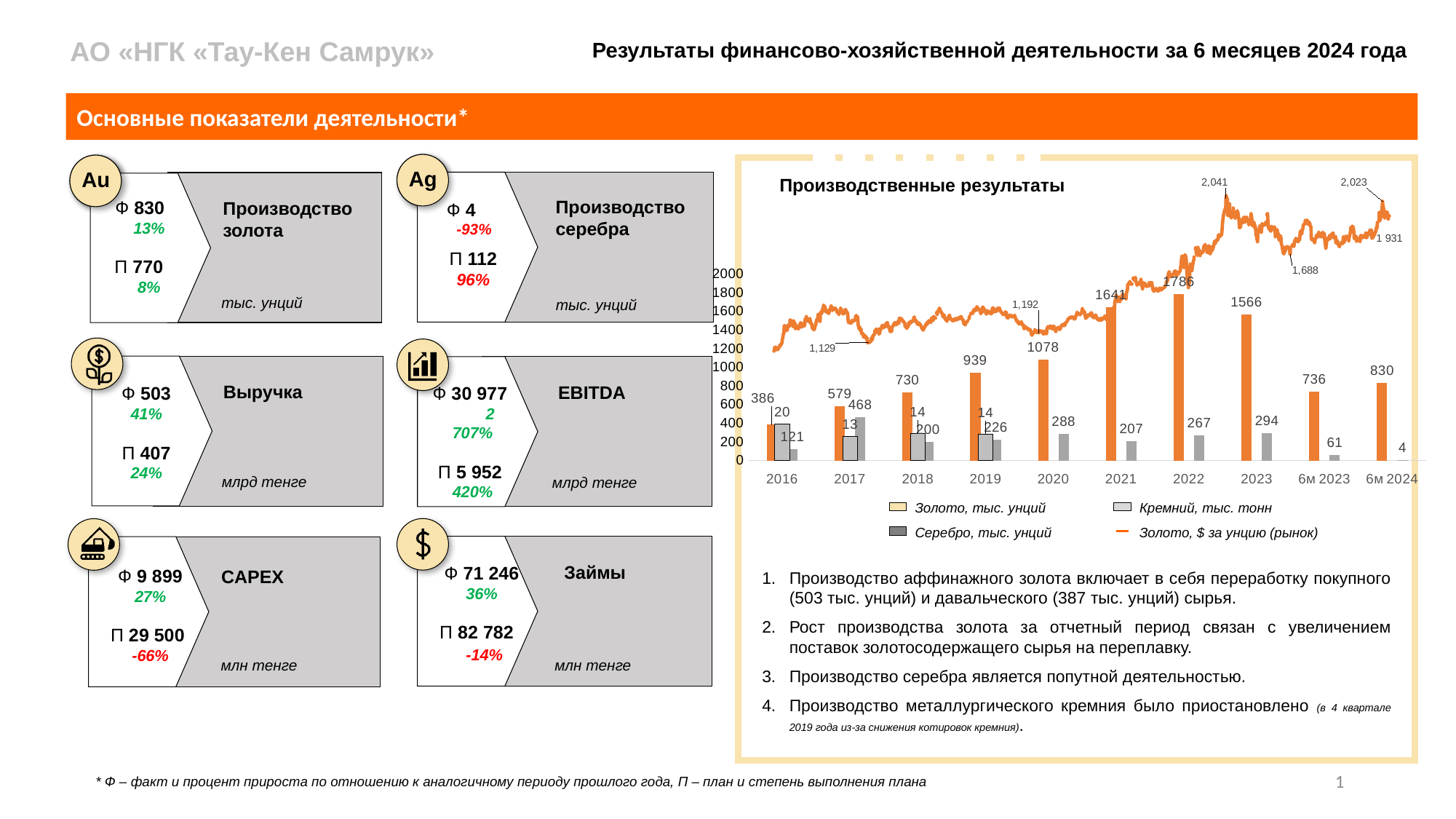
In the 'Производственные результаты' chart, what is the silver production value (Серебро, тыс. унций) for 2017? 468 Which category has the lowest silver production value in the 'Производственные результаты' chart? 6м 2024 How many categories are shown on the x axis of the 'Производственные результаты' chart? 10 How many series does the legend of the 'Производственные результаты' chart list? 4 What is the title of the chart on the right side of the slide? Производственные результаты In the 'Производственные результаты' chart, what is the silicon production value (Кремний, тыс. тонн) for 2016? 20 In the 'Производственные результаты' chart, did gold production rise or fall from 2016 to 2022? rise What is the gold production value (Золото, тыс. унций) shown for 2022 in the 'Производственные результаты' chart? 1786 In the 'Производственные результаты' chart, what is the difference between gold production in 6м 2024 and 6м 2023? 94 In the 'Производственные результаты' chart, which is larger: gold production in 2021 or in 2023? 2021 Which year has the highest gold production bar in the 'Производственные результаты' chart? 2022 In the 'Производственные результаты' chart, what is the gold production value for 6м 2024? 830